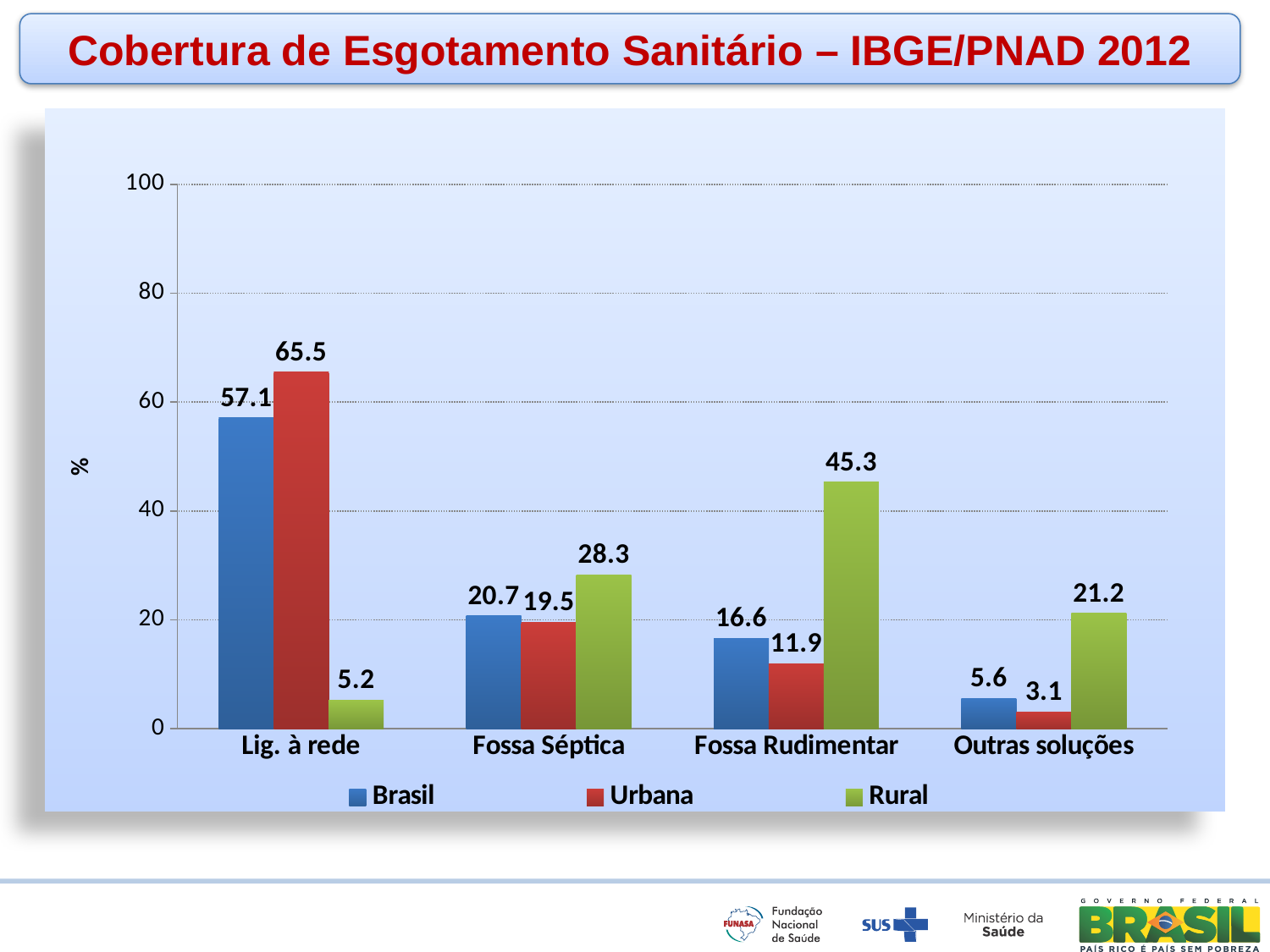
Which is larger in the Fossa Séptica category, the Brasil value or the Rural value? Rural What is the title of the slide? Cobertura de Esgotamento Sanitário – IBGE/PNAD 2012 What is the value for Rural in the Fossa Rudimentar category? 45.3 Which category has the highest Rural value? Fossa Rudimentar How many series does the legend list? 3 What is the difference between the Urbana and Rural values for Lig. à rede? 60.3 Which category has the lowest Urbana value? Outras soluções What kind of chart is shown on the slide? bar chart Is the Rural value for Fossa Rudimentar greater or less than 40? greater How many categories are shown on the x axis? 4 What is the value for Urbana in the Lig. à rede category? 65.5 What is the value for Brasil in the Outras soluções category? 5.6